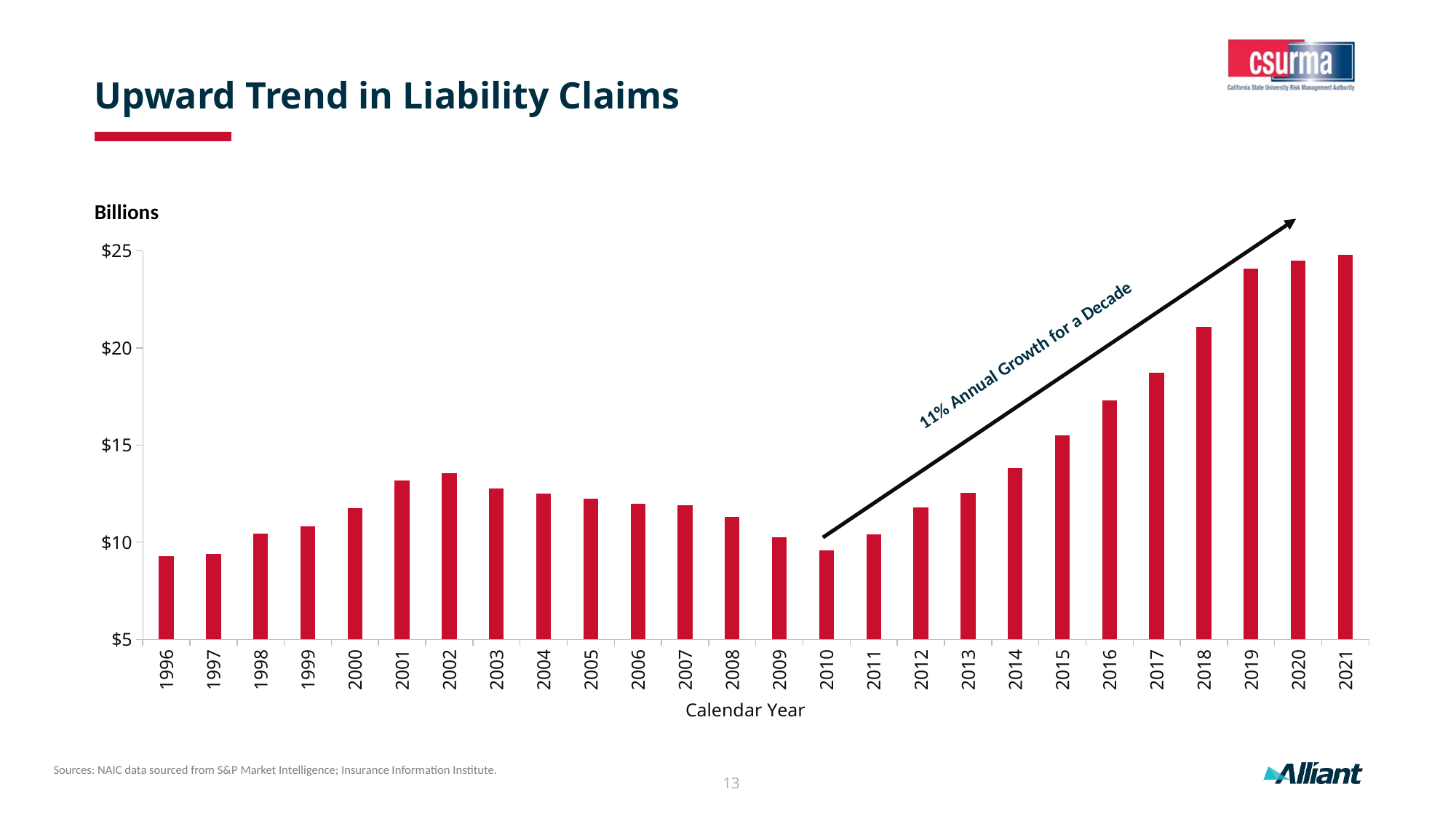
Which year has the larger value, 2002 or 2008? 2002 Is the value for 2019 greater or less than $20? greater How many calendar years are plotted on the x axis? 26 Is the value for 2010 greater or less than $10? less What does the annotation along the arrow on the chart say? 11% Annual Growth for a Decade Is the value for 2002 greater or less than $10? greater Which calendar year has the highest liability claims value? 2021 What is the title of the x axis? Calendar Year What kind of chart is shown on the slide? bar chart Do the values rise or fall from 2010 to 2021? rise